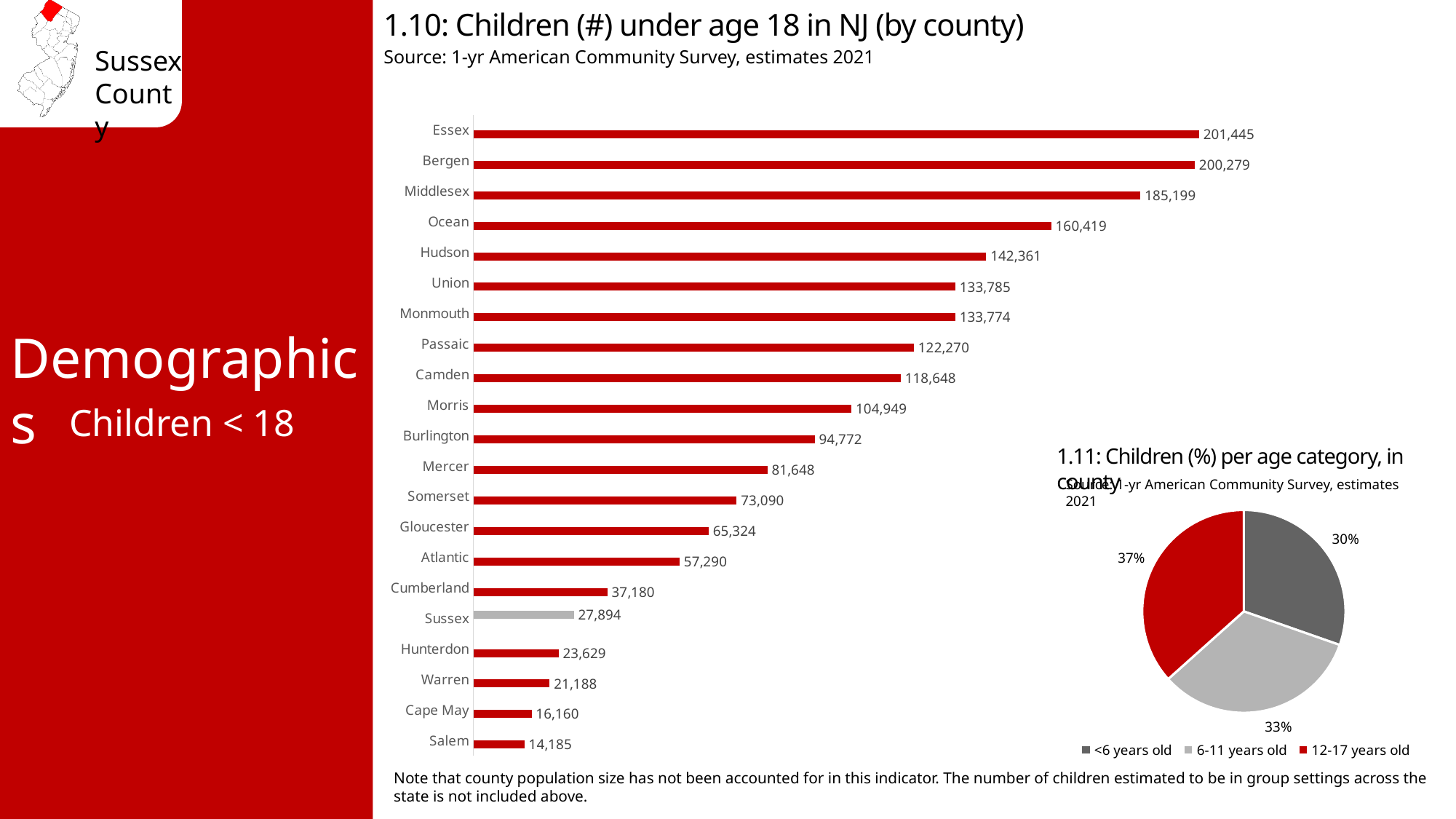
In the chart '1.10: Children (#) under age 18 in NJ (by county)', what is the difference between the values for Essex and Bergen? 1,166 How many categories does the legend of the pie chart '1.11: Children (%) per age category, in county' list? 3 In the chart '1.10: Children (#) under age 18 in NJ (by county)', how many counties are shown? 21 In the chart '1.10: Children (#) under age 18 in NJ (by county)', which county has more children under 18, Sussex or Hunterdon? Sussex In the pie chart '1.11: Children (%) per age category, in county', which age category has the smallest share? <6 years old In the chart '1.10: Children (#) under age 18 in NJ (by county)', which county has the highest number of children under 18? Essex In the pie chart '1.11: Children (%) per age category, in county', what share of children are 12-17 years old? 37% In the chart '1.10: Children (#) under age 18 in NJ (by county)', how many children under 18 are in Sussex county? 27,894 In the chart '1.10: Children (#) under age 18 in NJ (by county)', which county has the lowest number of children under 18? Salem What kind of chart is '1.10: Children (#) under age 18 in NJ (by county)'? Bar chart In the chart '1.10: Children (#) under age 18 in NJ (by county)', which county's bar is coloured grey instead of red? Sussex In the chart '1.10: Children (#) under age 18 in NJ (by county)', what is the value for Ocean county? 160,419